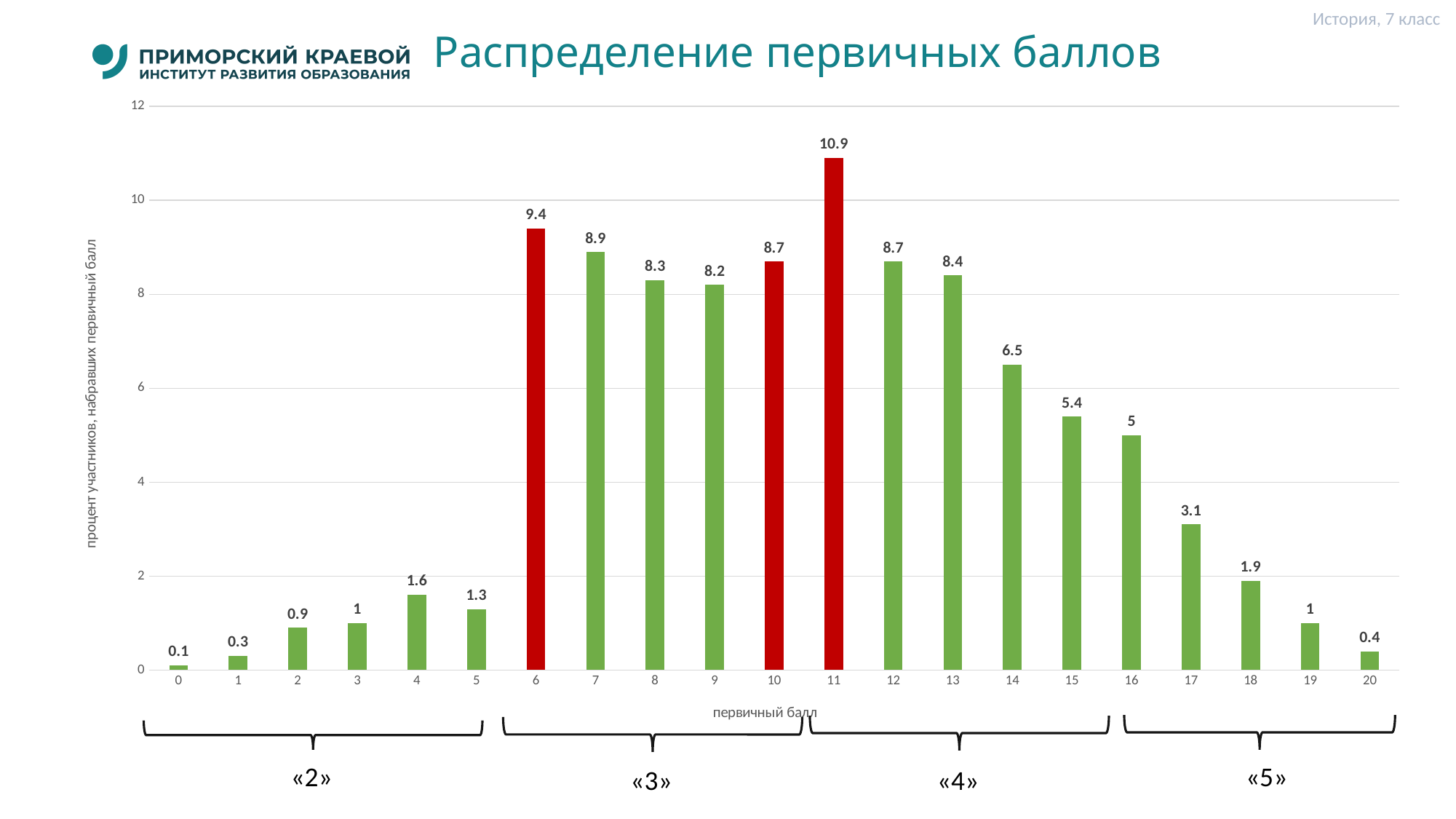
What is the difference between the values for primary scores 11 and 6? 1.5 What is the value for primary score 16? 5 What type of chart is shown on the slide? bar chart What is the value for primary score 6? 9.4 Which primary scores are shown with red bars? 6, 10 and 11 What is the value for primary score 11? 10.9 Which primary score has the highest percentage of participants? 11 Which is larger, the value for primary score 7 or for primary score 13? 7 How many primary score categories are plotted on the x axis? 21 Is the value for primary score 14 greater or less than 6? greater Do the values rise or fall along the x axis from primary score 11 to primary score 20? fall Which primary score has the lowest percentage of participants? 0